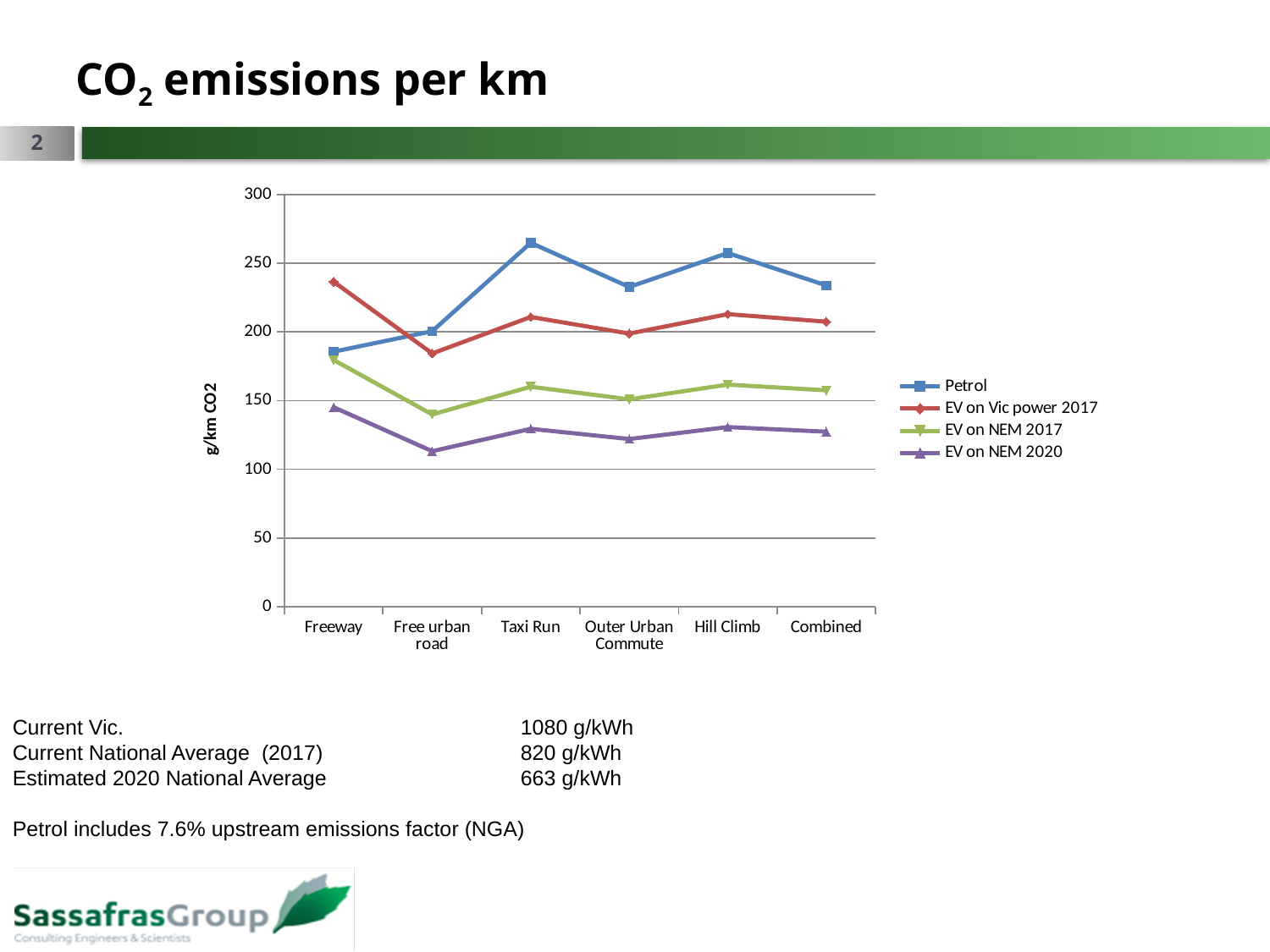
What is the label on the y axis? g/km CO2 Is the EV on NEM 2017 value for Freeway greater or less than 150? greater Is the Petrol value for Taxi Run greater or less than 250? greater For the Petrol series, which category has the highest value? Taxi Run For Free urban road, which is larger: Petrol or EV on Vic power 2017? Petrol What kind of chart is shown on the slide? line chart How many driving categories are shown on the x axis? 6 How many series does the legend list? 4 For the EV on NEM 2020 series, which category has the lowest value? Free urban road For the EV on Vic power 2017 series, which category has the lowest value? Free urban road For Freeway, which is larger: Petrol or EV on Vic power 2017? EV on Vic power 2017 Is the EV on NEM 2020 value for Free urban road greater or less than 150? less